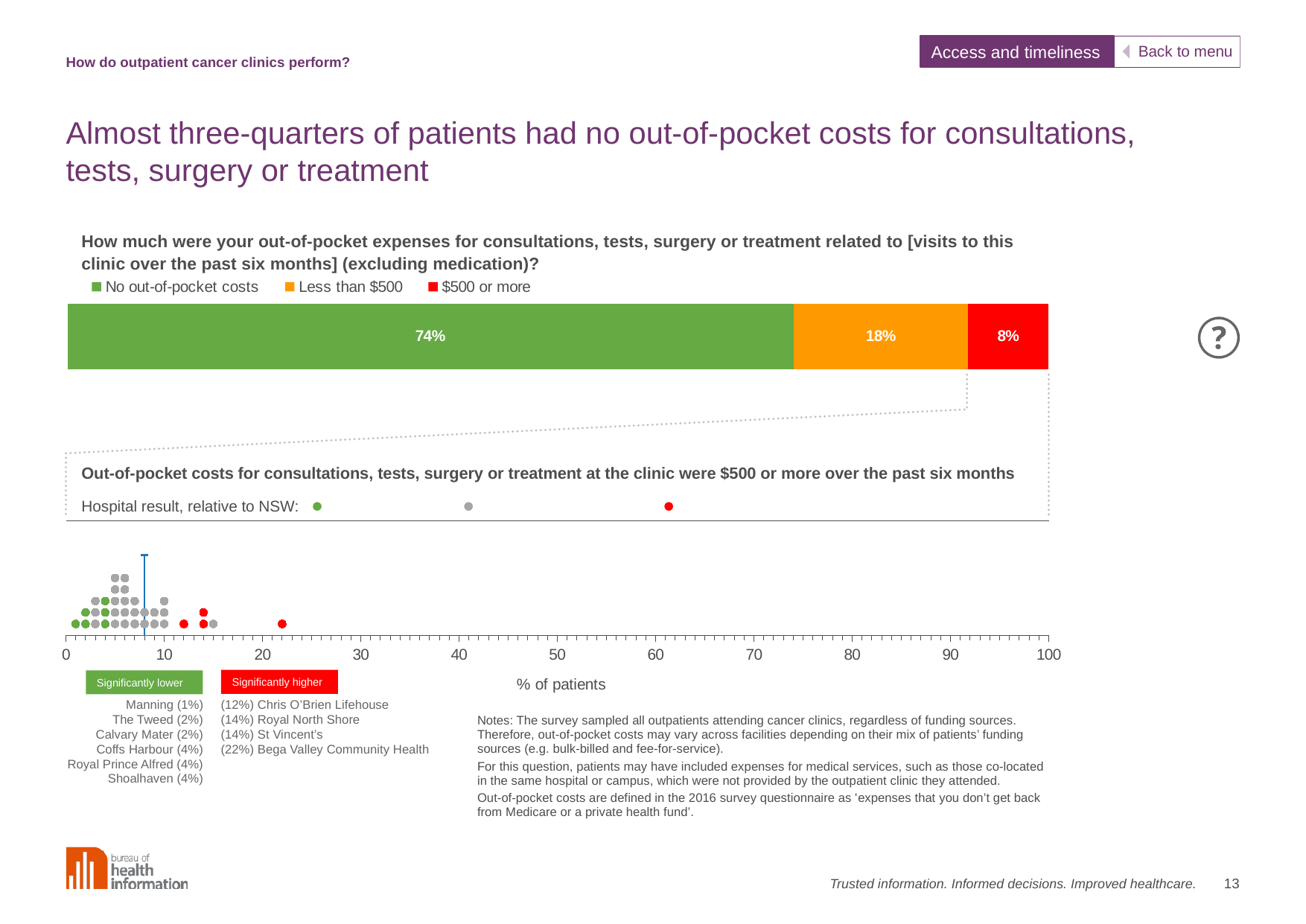
In the stacked bar chart, what percentage of patients had out-of-pocket costs of less than $500? 18% What is the total of the three segments in the stacked bar chart? 100% In the stacked bar chart, what is the difference in percentage points between 'No out-of-pocket costs' and 'Less than $500'? 56 What type of chart is used to show the breakdown of out-of-pocket expenses at the top of the slide? Stacked bar chart In the dot plot of hospital results, which hospital listed as significantly higher has the highest value? Bega Valley Community Health In the stacked bar chart, which response category has the smallest share of patients? $500 or more In the dot plot of hospital results, what is the value for Bega Valley Community Health? 22% How many hospitals are listed as significantly lower in the dot plot of hospital results? 6 In the stacked bar chart, what percentage of patients had no out-of-pocket costs? 74% In the stacked bar chart, which is larger: the share for 'Less than $500' or the share for '$500 or more'? Less than $500 In the stacked bar chart, what percentage of patients had out-of-pocket costs of $500 or more? 8% How many categories does the legend of the stacked bar chart list? 3